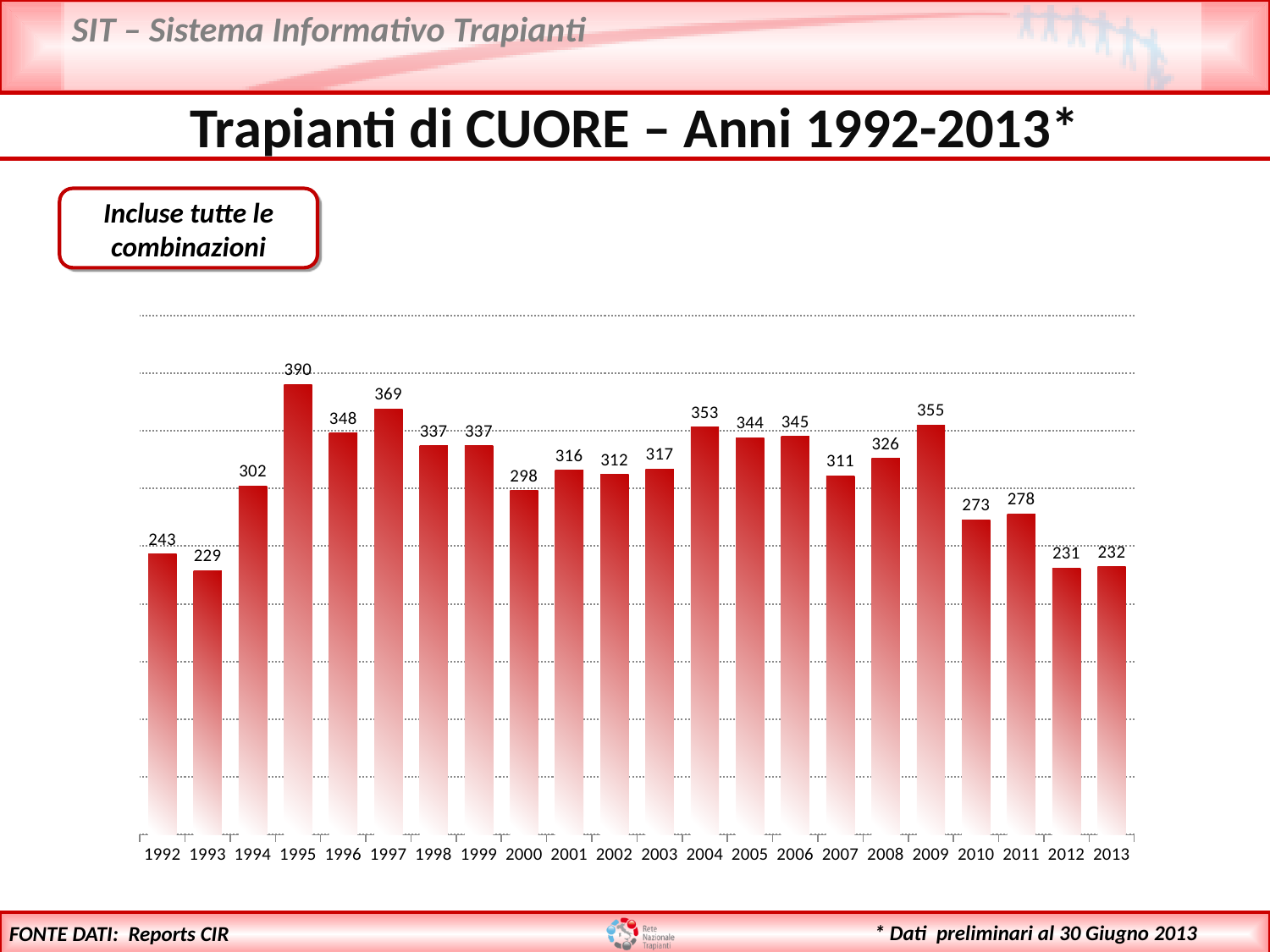
What kind of chart is this? bar chart Which is larger, the value for 1997 or the value for 2004? 1997 Which year has the lowest value? 1993 What is the value for 2013? 232 What is the value for 2009? 355 What is the difference between the values for 2009 and 2010? 82 How many years are shown on the x axis? 22 Do the values rise or fall from 2009 to 2012? fall What is the difference between the values for 1995 and 1993? 161 What is the value for 1995? 390 What is the title of the slide? Trapianti di CUORE – Anni 1992-2013* Which year has the highest value? 1995